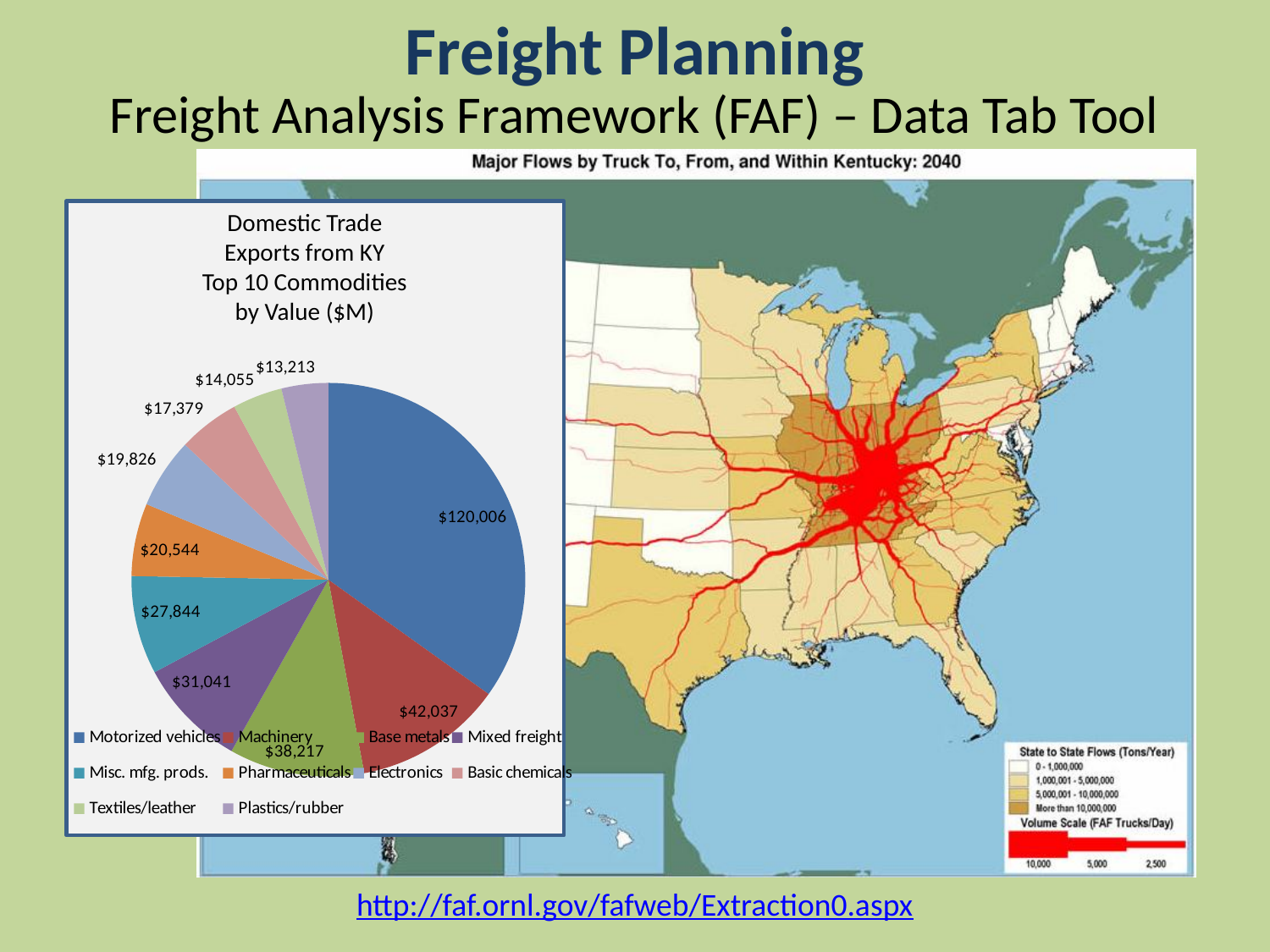
In the pie chart, what is the value for Machinery? $42,037 In the pie chart, what is the difference between the values for Machinery and Base metals? $3,820 Which commodity has the smallest slice in the pie chart? Plastics/rubber What type of chart is the 'Domestic Trade Exports from KY Top 10 Commodities by Value ($M)' chart? Pie chart Which commodity has the largest slice in the pie chart? Motorized vehicles How many commodity slices does the pie chart show? 10 In the pie chart, which is larger: Misc. mfg. prods. or Mixed freight? Mixed freight What unit of value does the pie chart title say the commodities are measured in? $M In the pie chart, what is the value for Pharmaceuticals? $20,544 In the pie chart, what is the value for Motorized vehicles? $120,006 In the pie chart, what is the difference between the values for Motorized vehicles and Machinery? $77,969 In the pie chart, what is the value for Plastics/rubber? $13,213